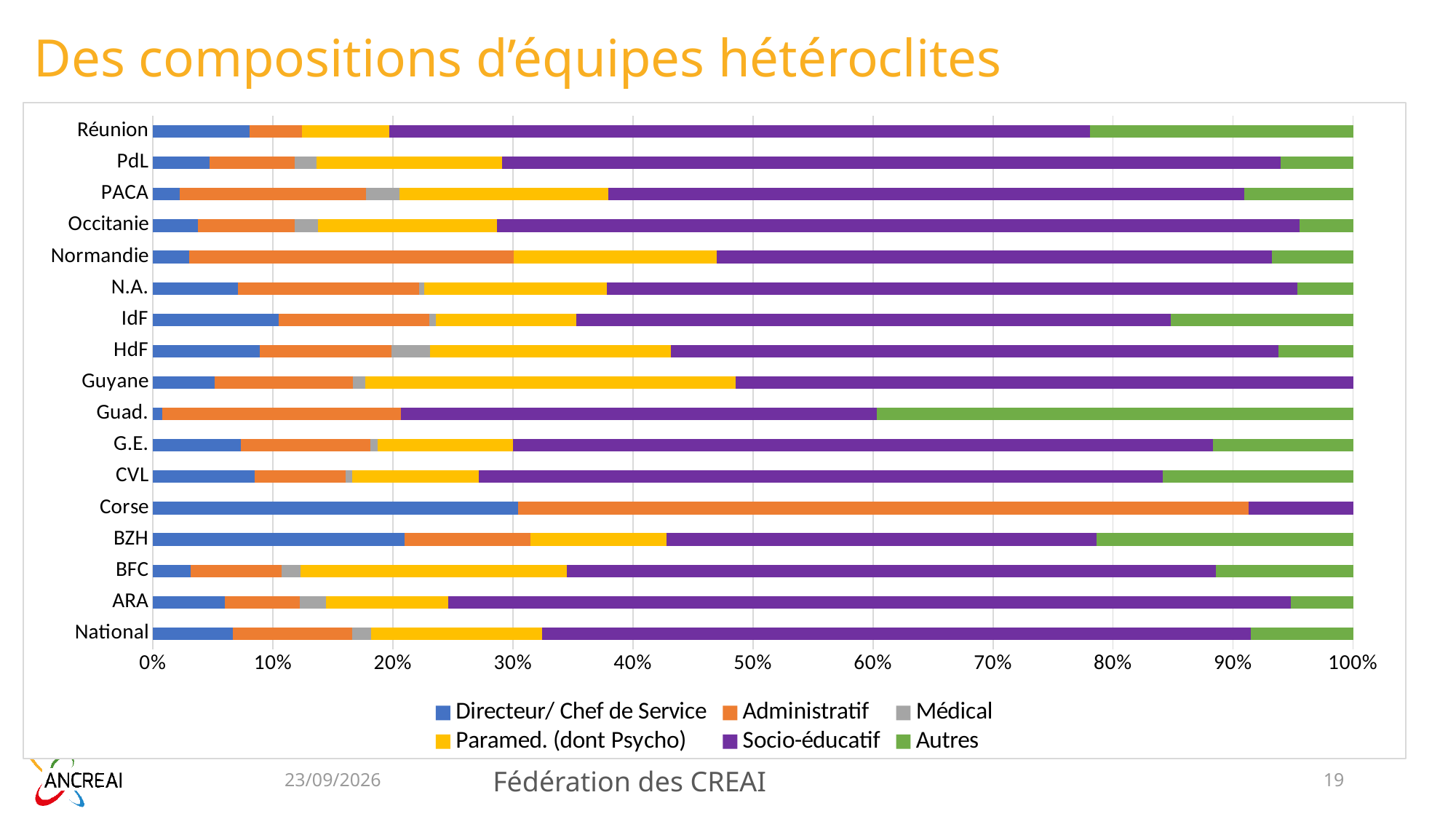
How many regions (categories) are listed on the vertical axis of the chart? 17 Is the Directeur/ Chef de Service share for Corse greater or less than 20%? greater What kind of chart is shown on the slide? Stacked bar chart Which region has the larger Directeur/ Chef de Service share, BZH or Réunion? BZH Which region has the largest share for Autres? Guad. Is the Administratif share for Corse greater or less than 50%? greater What is the title of the slide containing the chart? Des compositions d’équipes hétéroclites Which region has the largest share for Administratif? Corse Which region has the largest share for Directeur/ Chef de Service? Corse How many series does the chart legend list? 6 Is the Autres share for Guad. greater or less than 30%? greater